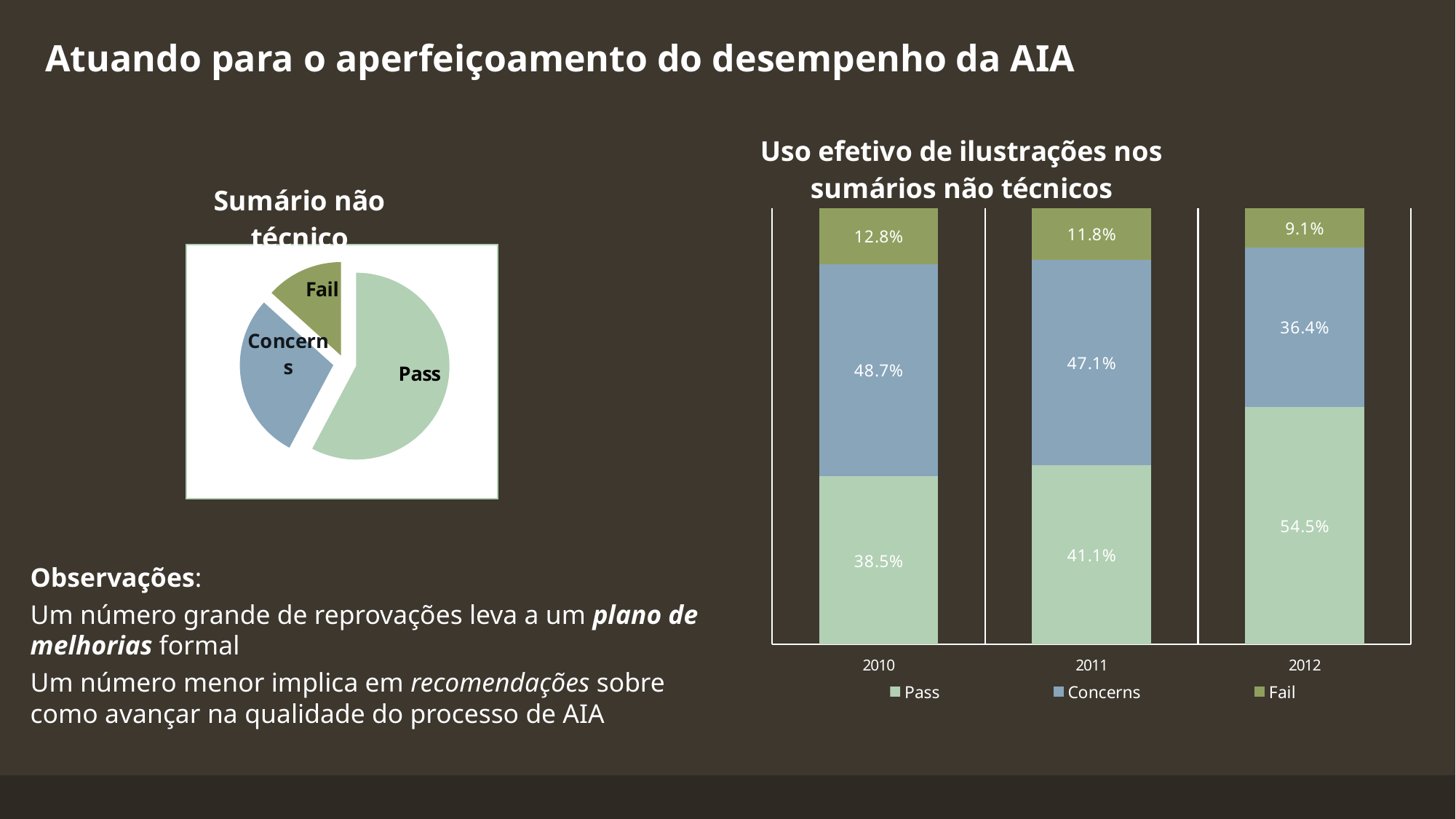
In the chart 'Uso efetivo de ilustrações nos sumários não técnicos', which year has the lowest Fail value? 2012 In the chart 'Uso efetivo de ilustrações nos sumários não técnicos', what is the Concerns value for 2010? 48.7% In the chart 'Uso efetivo de ilustrações nos sumários não técnicos', does the Fail value rise or fall from 2010 to 2012? fall What kind of chart is the chart titled 'Sumário não técnico' on the left of the slide? pie chart In the chart 'Uso efetivo de ilustrações nos sumários não técnicos', how many series does the legend list? 3 In the chart 'Uso efetivo de ilustrações nos sumários não técnicos', what is the Fail value for 2011? 11.8% In the chart 'Uso efetivo de ilustrações nos sumários não técnicos', what is the Pass value for 2012? 54.5% In the chart 'Uso efetivo de ilustrações nos sumários não técnicos', which year has the highest Pass value? 2012 In the chart 'Uso efetivo de ilustrações nos sumários não técnicos', how many years are shown on the x axis? 3 In the pie chart 'Sumário não técnico', which slice is the largest? Pass In the chart 'Uso efetivo de ilustrações nos sumários não técnicos', what is the difference between the Pass values for 2012 and 2010? 16.0% In the chart 'Uso efetivo de ilustrações nos sumários não técnicos', is the Concerns value larger in 2010 or in 2012? 2010